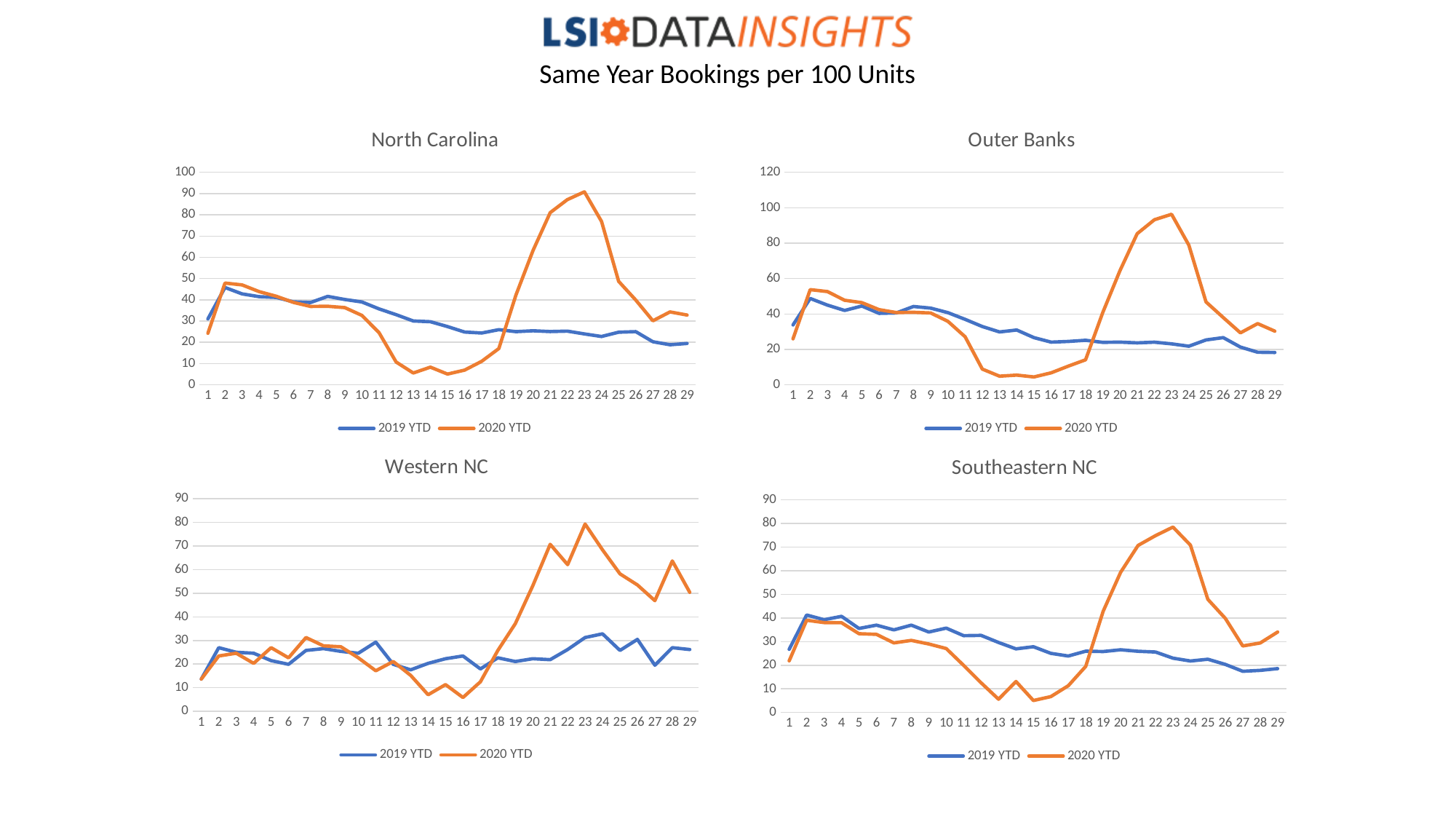
How many series does the legend of the Outer Banks chart list? 2 In the Outer Banks chart, which series has the larger value at point 15, 2019 YTD or 2020 YTD? 2019 YTD In the Southeastern NC chart, does the 2020 YTD series rise or fall between points 18 and 23? rise In the Southeastern NC chart, is the 2020 YTD value at point 13 greater or less than 10? less What kind of chart is the North Carolina chart? line chart How many points are plotted along the x axis of the Western NC chart? 29 In the North Carolina chart, at which x-axis point does the 2020 YTD series reach its highest value? 23 What is the overall title shown above the four charts on the slide? Same Year Bookings per 100 Units In the Outer Banks chart, is the 2020 YTD value at point 23 greater or less than 80? greater In the North Carolina chart, which series has the larger value at point 23, 2019 YTD or 2020 YTD? 2020 YTD In the North Carolina chart, is the 2020 YTD value at point 13 greater or less than 10? less